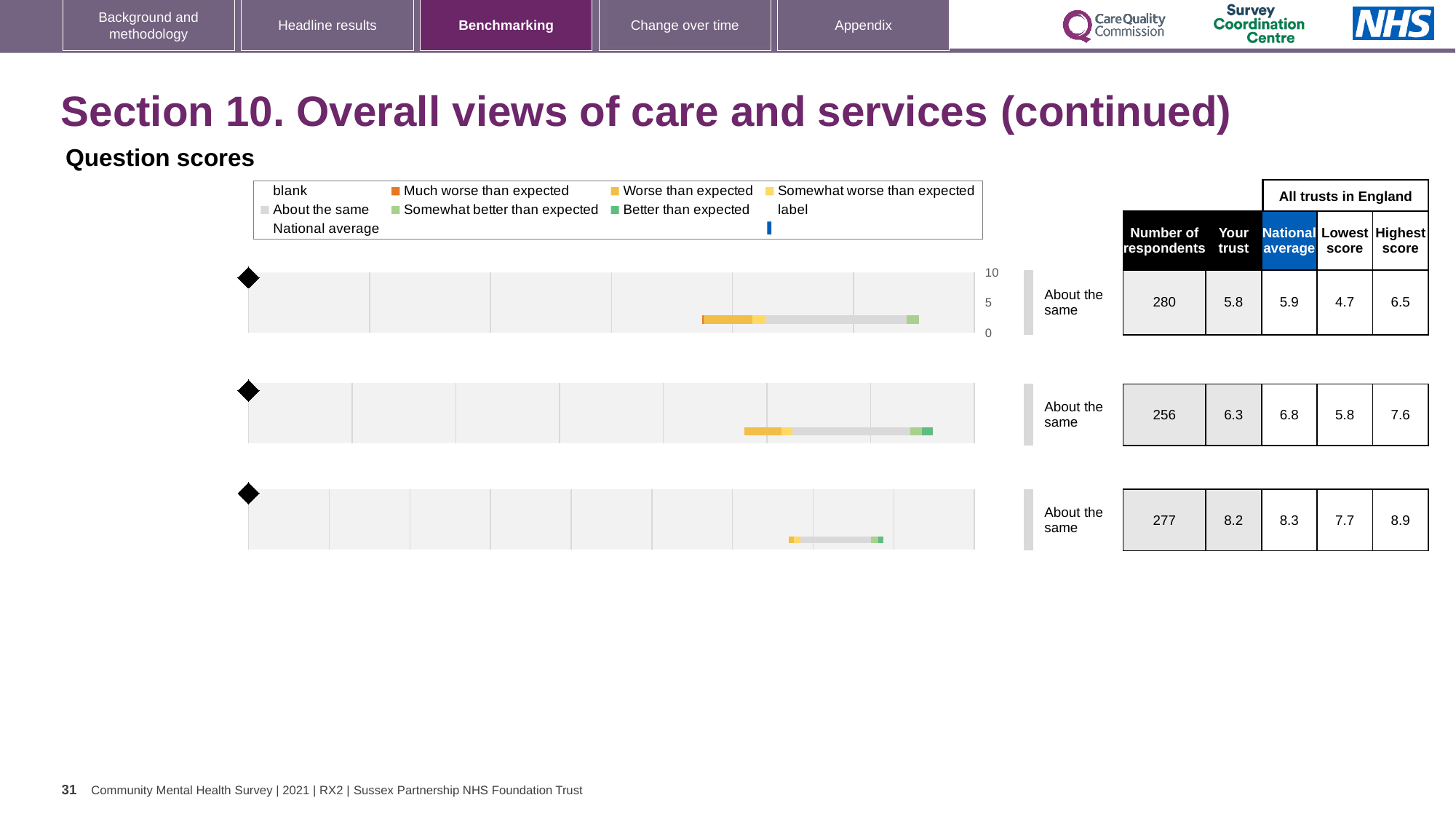
For the top chart, what is the 'Your trust' score? 5.8 For the middle chart, what is the lowest score among all trusts in England? 5.8 Which chart has the largest number of respondents? The top chart (280) For the middle chart, what is the national average score? 6.8 How many question score charts are shown on the slide? 3 For the middle chart, how much higher is the national average than the 'Your trust' score? 0.5 What kind of chart is used to show the question scores on this slide? bar chart For the top chart, which is larger: the 'Your trust' score or the national average? National average What benchmark rating is shown next to the top chart? About the same For the bottom chart, what is the difference between the highest score and the lowest score? 1.2 Which of the three charts has the highest 'Your trust' score? The bottom chart (8.2) For the bottom chart, how many respondents are there? 277